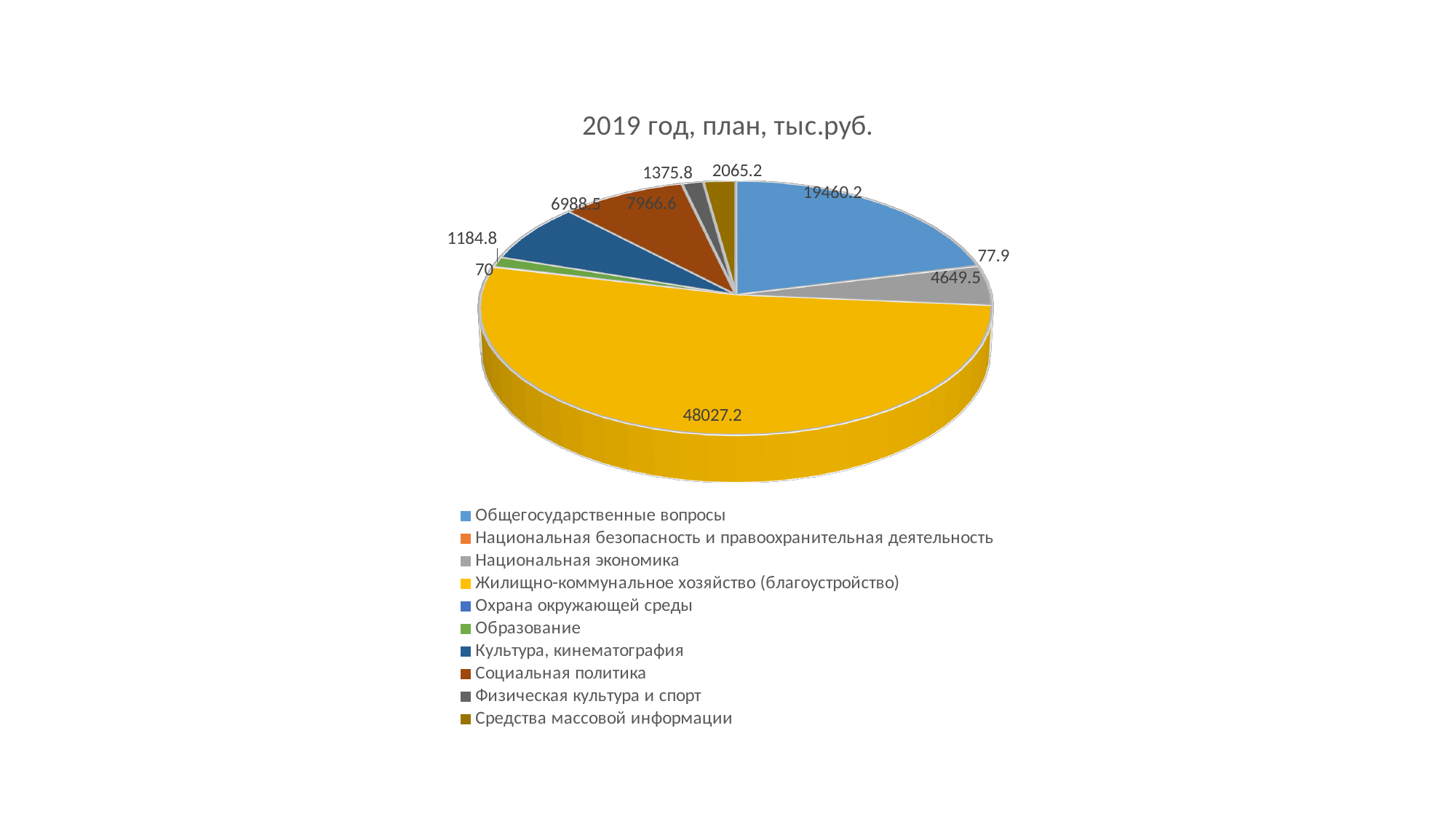
What is the value for Социальная политика? 7966.6 What kind of chart is shown on the slide? Pie chart Which is larger, Средства массовой информации or Физическая культура и спорт? Средства массовой информации What is the value for Жилищно-коммунальное хозяйство (благоустройство)? 48027.2 Which category has the largest value? Жилищно-коммунальное хозяйство (благоустройство) What is the value for Охрана окружающей среды? 70 What is the value for Общегосударственные вопросы? 19460.2 Which category has the smallest value? Охрана окружающей среды What is the difference between Жилищно-коммунальное хозяйство (благоустройство) and Общегосударственные вопросы? 28567 What is the difference between Социальная политика and Культура, кинематография? 978.1 What is the title of the chart? 2019 год, план, тыс.руб. How many categories does the pie chart show? 10